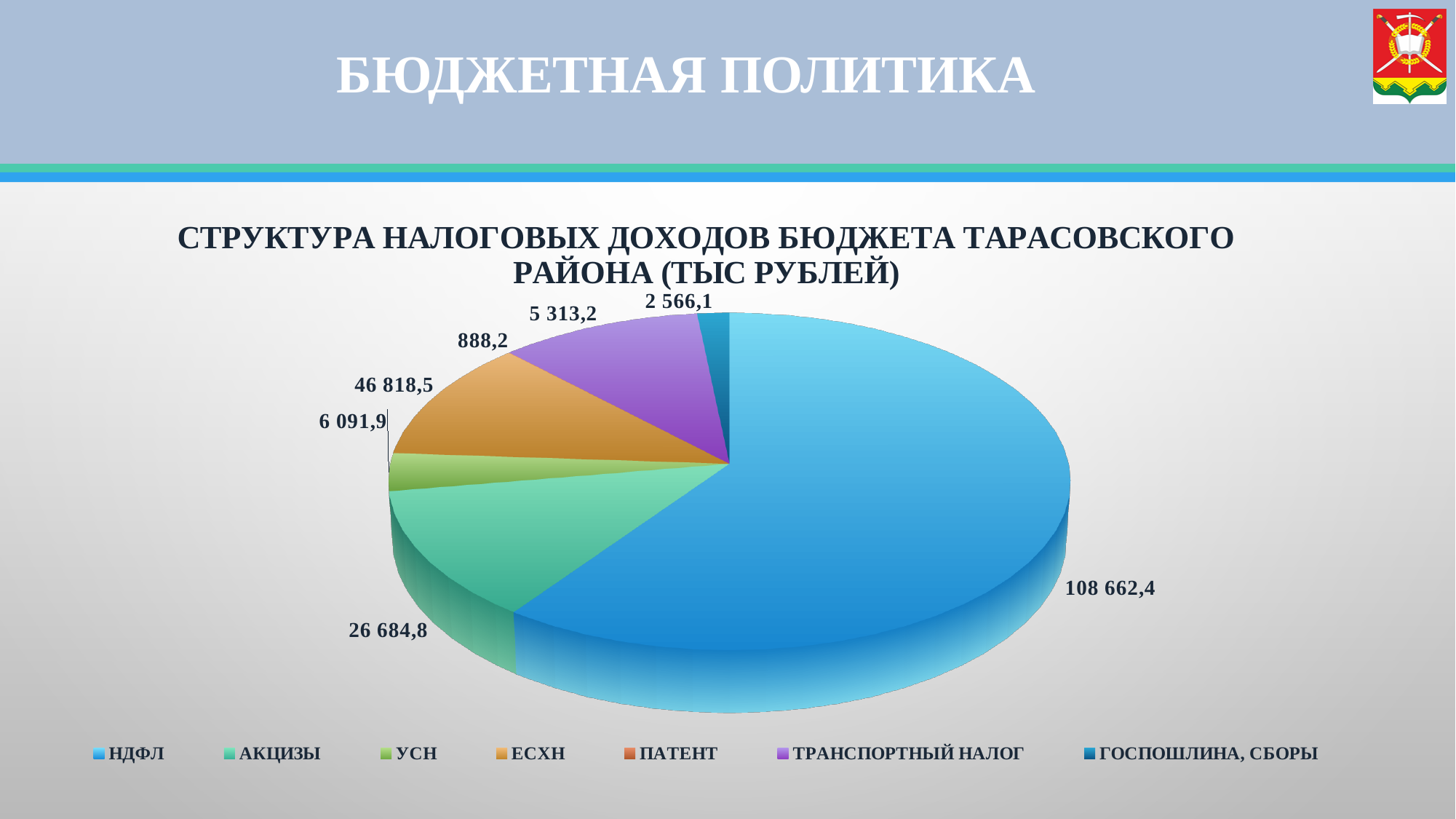
What is the value for ЕСХН in the pie chart? 46 818,5 Which category has the smallest slice of the pie? ПАТЕНТ What is the value for АКЦИЗЫ in the pie chart? 26 684,8 What is the value for ГОСПОШЛИНА, СБОРЫ in the pie chart? 2 566,1 Which is larger, the value for АКЦИЗЫ or the value for УСН? АКЦИЗЫ What kind of chart is shown on the slide? pie chart What is the title of the pie chart? СТРУКТУРА НАЛОГОВЫХ ДОХОДОВ БЮДЖЕТА ТАРАСОВСКОГО РАЙОНА (ТЫС РУБЛЕЙ) Which category has the largest slice of the pie? НДФЛ What is the difference between the values for НДФЛ and ЕСХН? 61 843,9 How many categories does the legend of the pie chart list? 7 What is the value for НДФЛ in the pie chart? 108 662,4 What is the value for ТРАНСПОРТНЫЙ НАЛОГ in the pie chart? 5 313,2